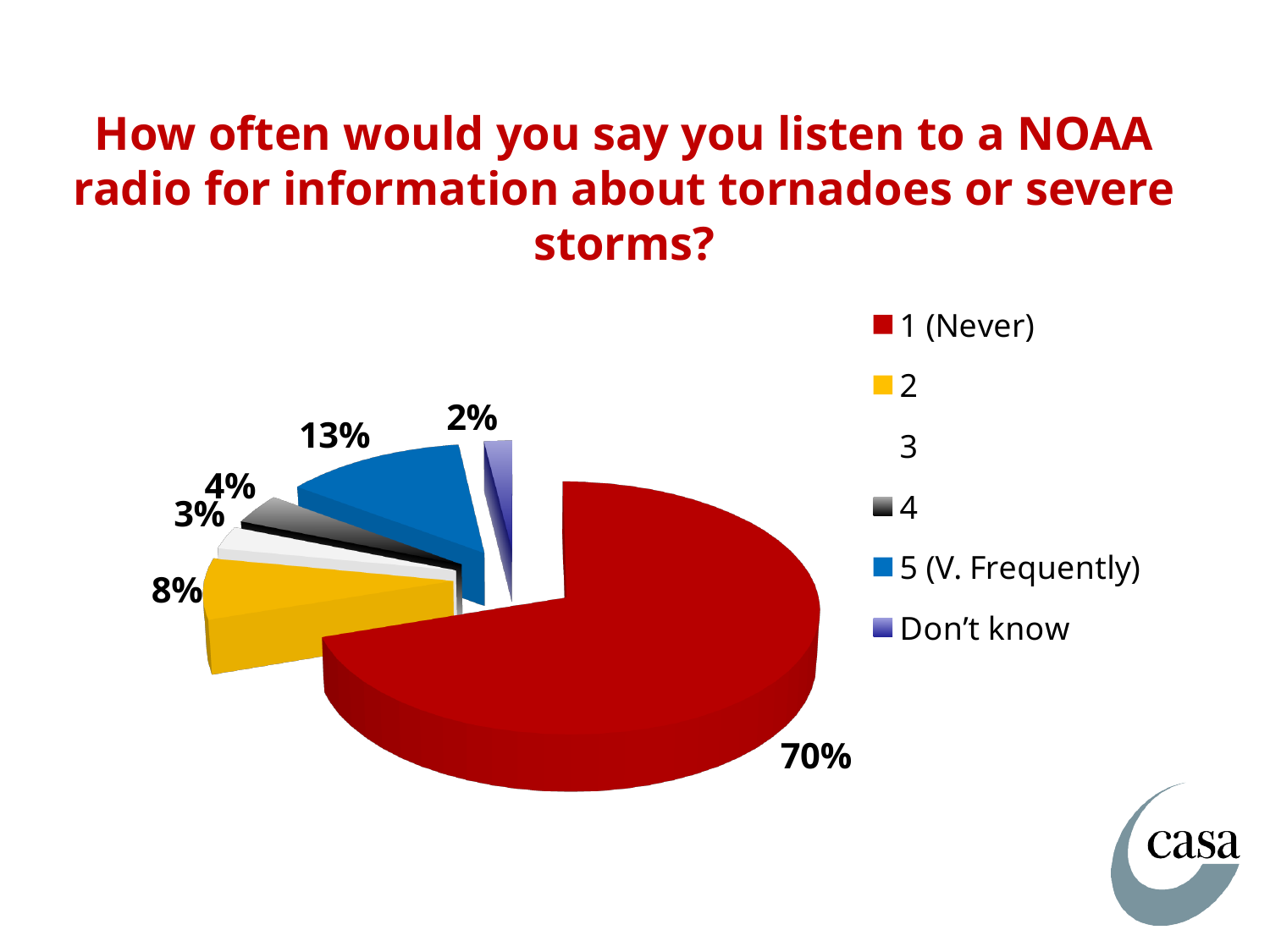
What is the difference in percentage points between "1 (Never)" and "5 (V. Frequently)"? 57 What percentage of respondents answered "2"? 8% Which response category has the largest share of the pie? 1 (Never) Which is larger, the share for "2" or the share for "4"? 2 What percentage of respondents answered "1 (Never)"? 70% How many categories does the legend list? 6 What percentage of respondents answered "5 (V. Frequently)"? 13% What colour is the slice for "1 (Never)"? red What percentage of respondents answered "Don't know"? 2% What percentage of respondents answered "4"? 4% Which response category has the smallest share of the pie? Don't know What kind of chart is shown on the slide? pie chart